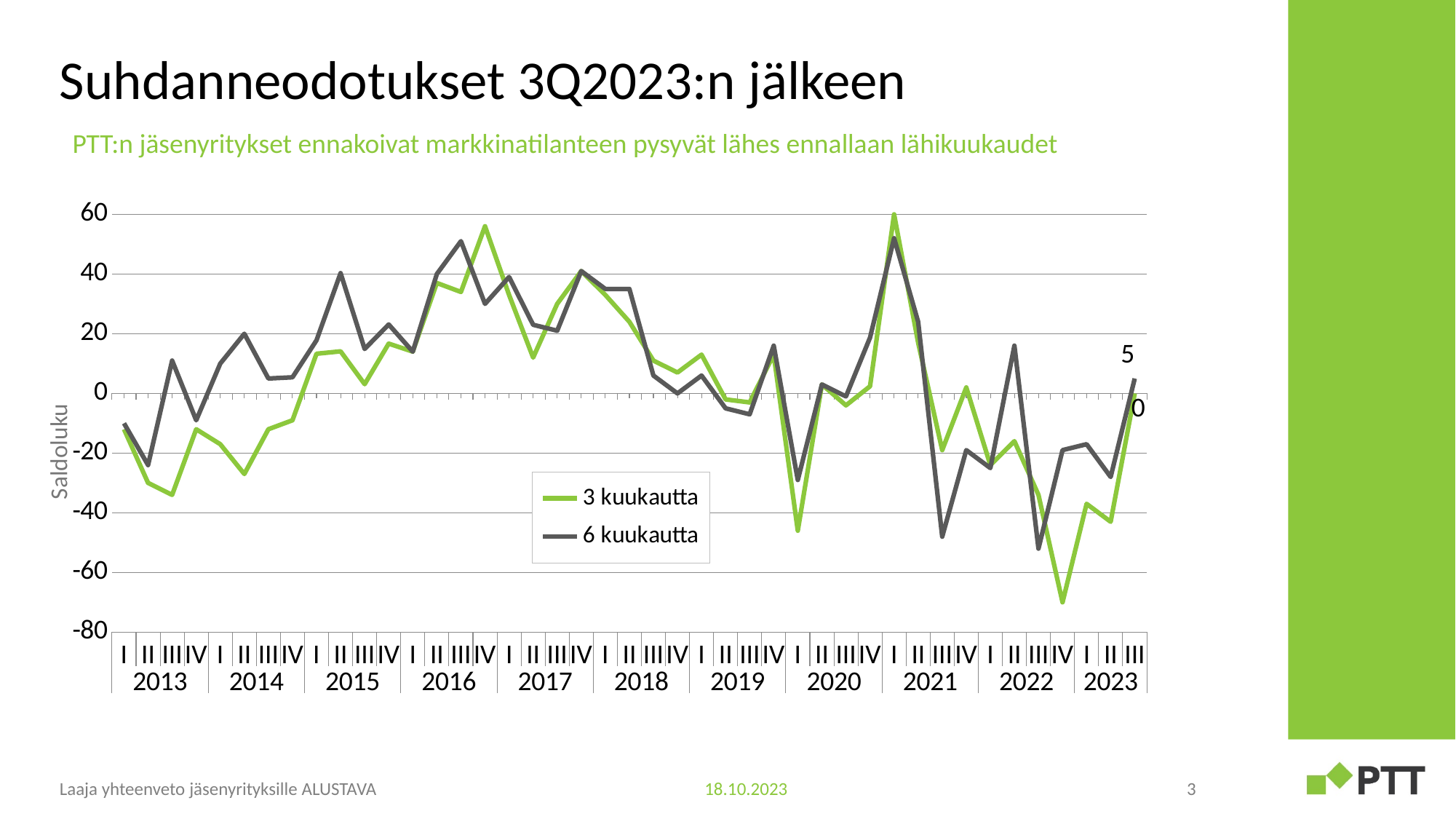
What is the value of the 3 kuukautta series at 2023 III? 0 What is the value of the 6 kuukautta series at 2023 III? 5 How many series does the legend list? 2 What is the title of the y axis? Saldoluku Is the value of the 6 kuukautta series at 2022 III greater or less than -40? less In which quarter does the 3 kuukautta series reach its lowest value? 2022 IV What kind of chart is shown on the slide? line chart At 2023 III, which series has the higher value, 3 kuukautta or 6 kuukautta? 6 kuukautta Is the value of the 3 kuukautta series at 2022 III greater or less than -60? greater What is the difference between the 6 kuukautta and 3 kuukautta values at 2023 III? 5 Is the value of the 3 kuukautta series at 2021 I greater or less than 40? greater How many years are labelled on the x axis? 11